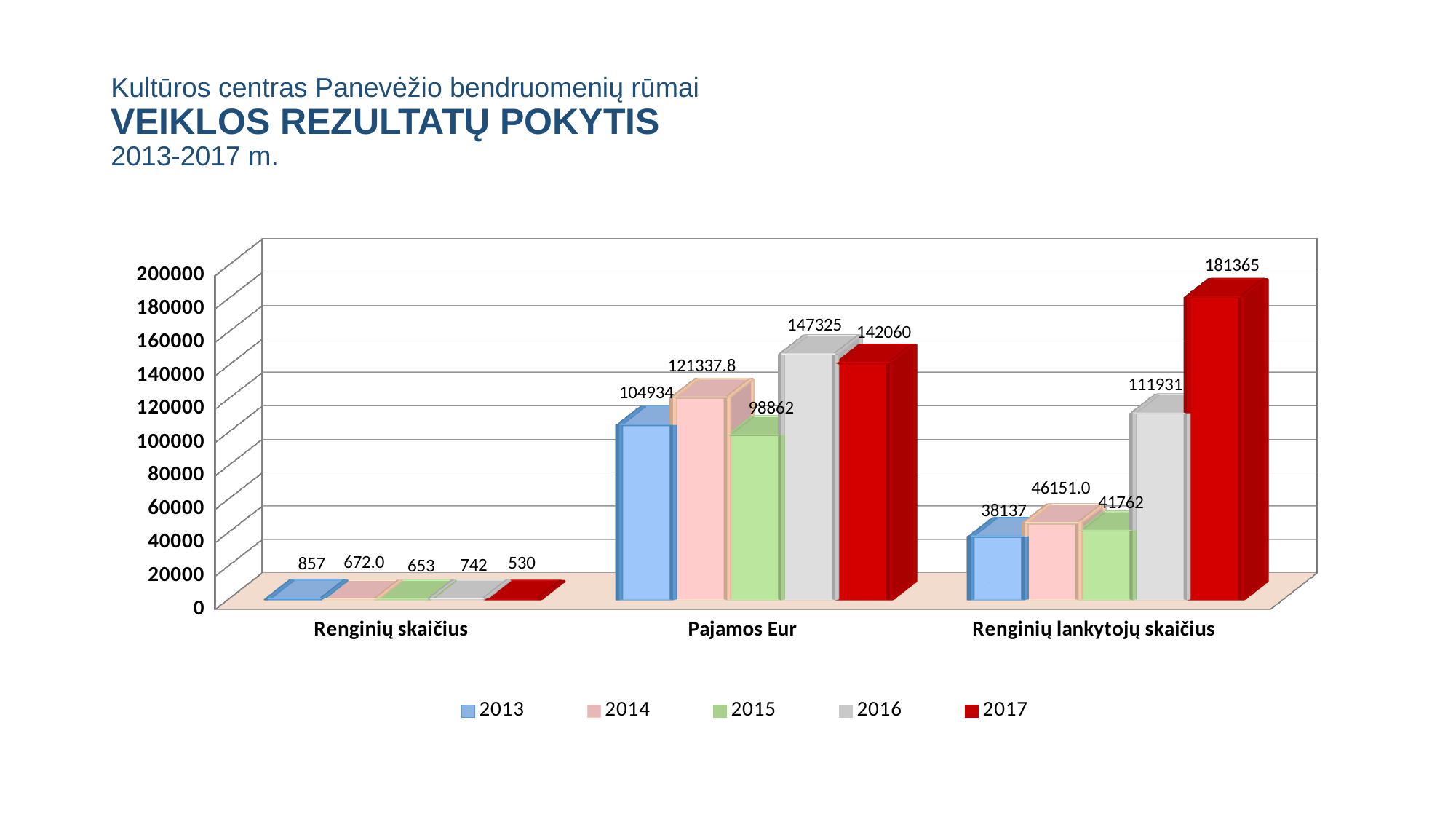
How many series does the legend list? 5 How many categories are shown on the x axis? 3 What is the value for 2013 in the Renginių skaičius category? 857 What is the value for 2017 in the Renginių lankytojų skaičius category? 181365 Which colour represents the 2017 series in the legend? Red What is the value for 2014 in the Pajamos Eur category? 121337.8 What kind of chart is shown on the slide? Bar chart What is the value for 2016 in the Renginių lankytojų skaičius category? 111931 Which is larger in the Pajamos Eur category: the value for 2013 or the value for 2015? 2013 What is the difference between the 2017 and 2016 values in the Renginių lankytojų skaičius category? 69434 Which year has the highest value in the Pajamos Eur category? 2016 Which year has the lowest value in the Renginių skaičius category? 2017